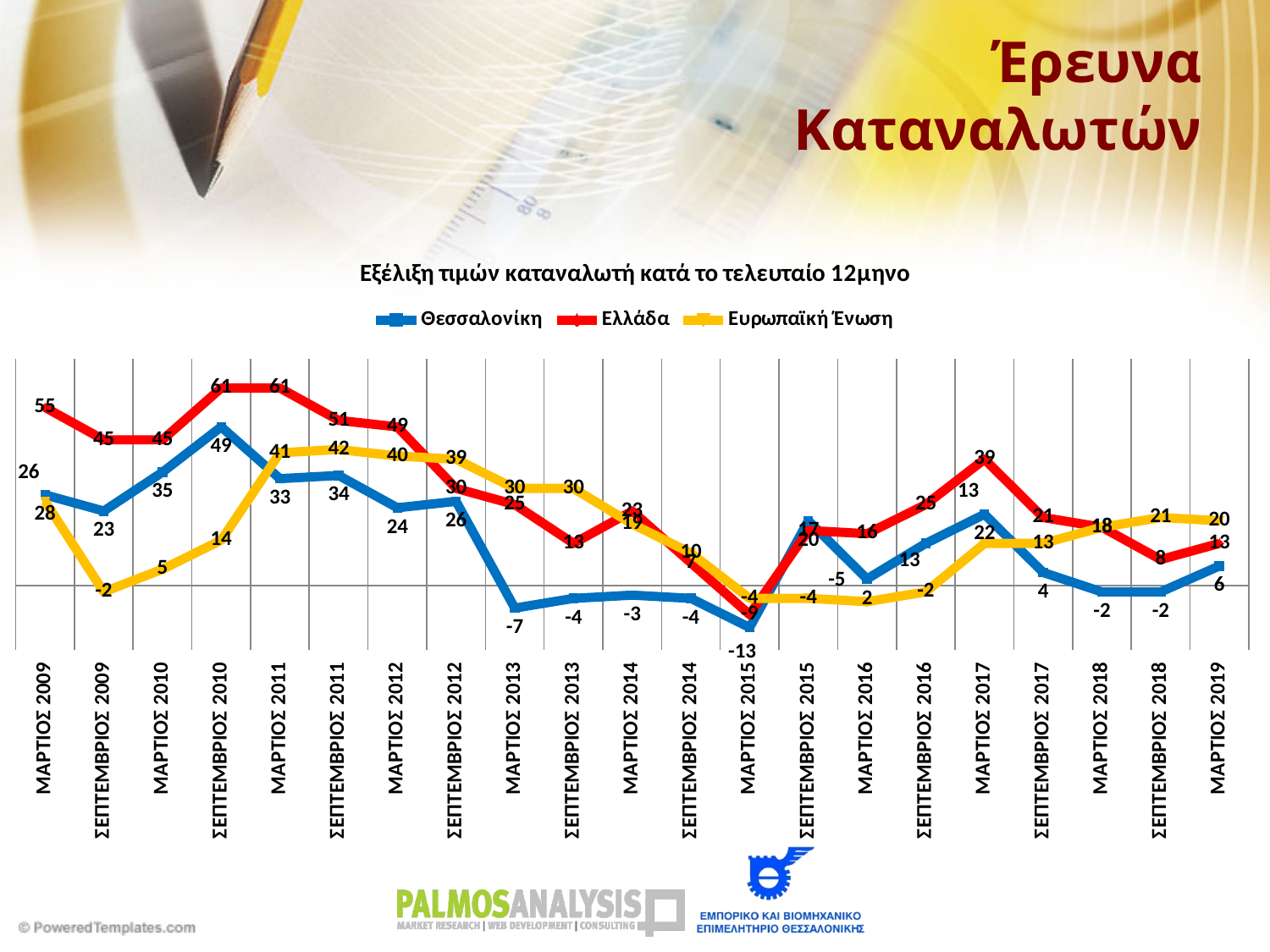
How many series does the legend list? 3 How many time points are plotted along the x axis? 21 What is the highest value reached by Ελλάδα? 61 What kind of chart is shown on the slide? Line chart In which period does Θεσσαλονίκη reach its lowest value? ΜΑΡΤΙΟΣ 2015 What is the value for Ελλάδα in ΜΑΡΤΙΟΣ 2009? 55 What is the value for Ευρωπαϊκή Ένωση in ΣΕΠΤΕΜΒΡΙΟΣ 2011? 42 What is the difference between Ελλάδα and Θεσσαλονίκη in ΣΕΠΤΕΜΒΡΙΟΣ 2010? 12 What is the value for Θεσσαλονίκη in ΜΑΡΤΙΟΣ 2019? 6 In which period does Θεσσαλονίκη reach its highest value? ΣΕΠΤΕΜΒΡΙΟΣ 2010 What is the value for Ευρωπαϊκή Ένωση in ΜΑΡΤΙΟΣ 2019? 20 Which series has the larger value in ΜΑΡΤΙΟΣ 2011, Ελλάδα or Ευρωπαϊκή Ένωση? Ελλάδα